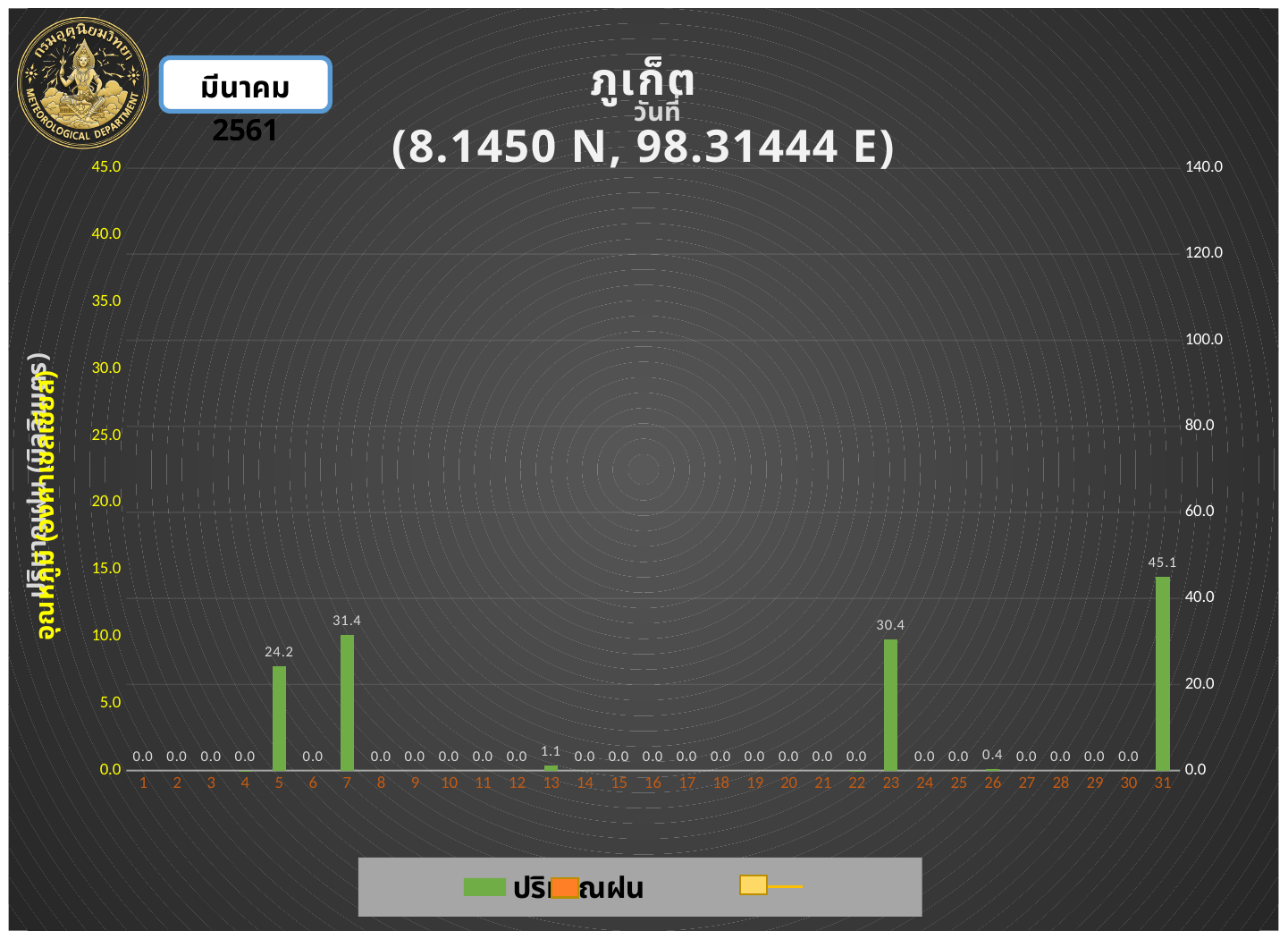
What is the value for day 31? 45.1 What is the difference between the values for day 7 and day 23? 1.0 How many days are shown on the x axis? 31 Which day has the highest value? 31 What is the difference between the values for day 31 and day 5? 20.9 What is the value for day 23? 30.4 What is the value for day 7? 31.4 What kind of chart is this? bar chart What is the value for day 13? 1.1 What is the value for day 5? 24.2 What is the value for day 26? 0.4 Which is larger, the value for day 7 or the value for day 23? day 7